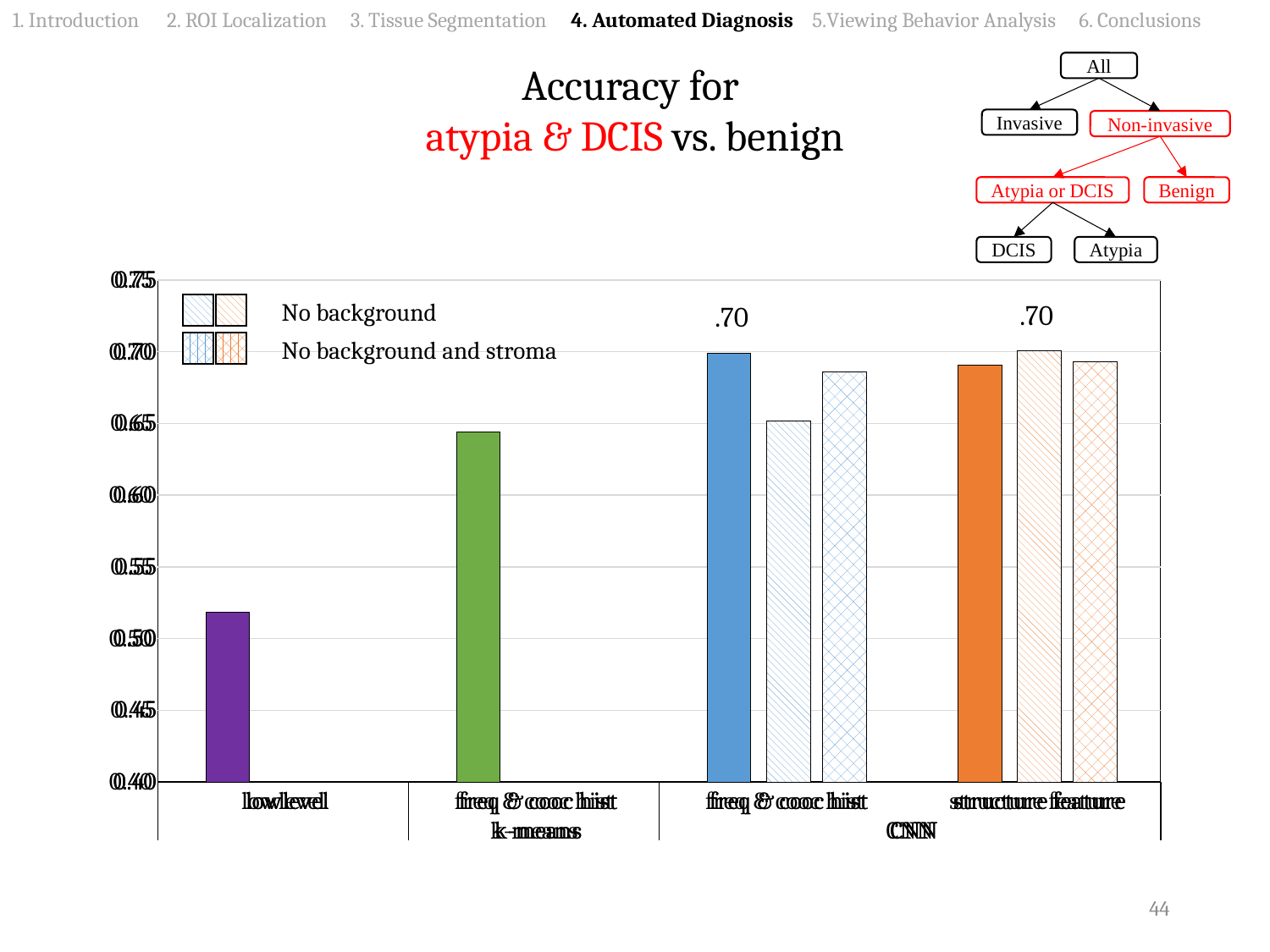
How many entries does the chart legend list? 2 Which category has the lowest accuracy in the chart? lowlevel Is the accuracy for lowlevel greater or less than 0.55? less Which has higher accuracy: lowlevel or freq & cooc hist with k-means? freq & cooc hist (k-means) What kind of chart is shown on the slide? bar chart Is the accuracy for freq & cooc hist with k-means greater or less than 0.60? greater What are the two legend entries in the chart? No background; No background and stroma How many category labels are shown along the x axis of the chart? 4 Do the accuracy values generally rise or fall moving from lowlevel on the left to the CNN methods on the right? rise What data label is printed above the CNN freq & cooc hist group of bars? .70 What data label is printed above the structure feature group of bars? .70 What is the title of the chart? Accuracy for atypia & DCIS vs. benign